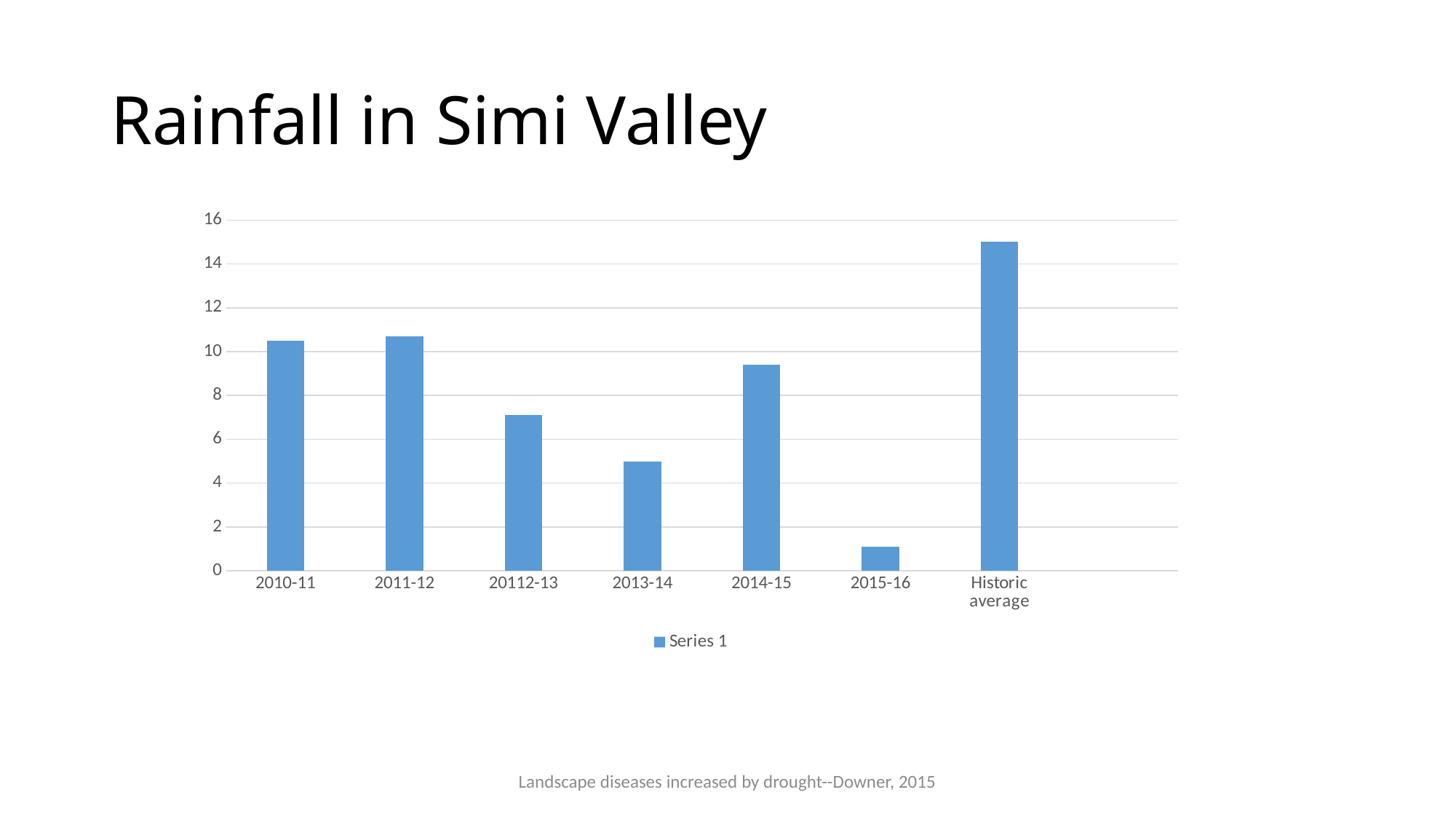
Which category has the lowest value? 2015-16 Is the value for 20112-13 greater or less than 8? less What is the title of the slide containing the chart? Rainfall in Simi Valley How many categories are shown on the x axis? 7 What kind of chart is shown on the slide? bar chart Is the value for Historic average greater or less than 14? greater How many series does the legend list? 1 Is the value for 2014-15 greater or less than 8? greater Which category has the highest value? Historic average Which is larger, the value for 2013-14 or the value for 2015-16? 2013-14 Which is larger, the value for 2014-15 or the value for 20112-13? 2014-15